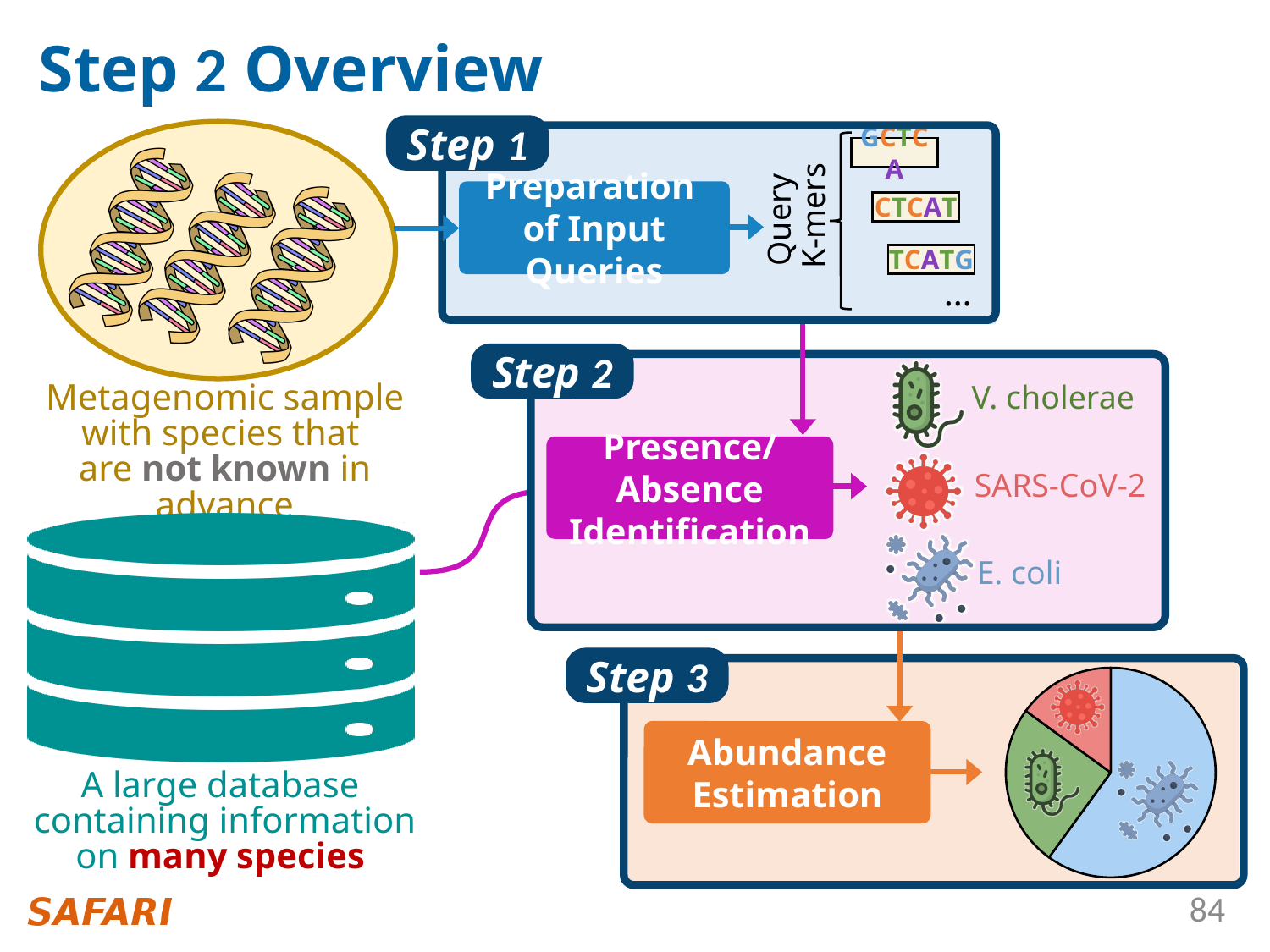
What kind of chart is shown in the Step 3 box? pie chart In the pie chart in the Step 3 box, is the blue slice larger or smaller than the green slice? larger Does the pie chart in the Step 3 box show any data labels or percentages? No How many slices does the pie chart in the Step 3 box have? 3 Which colour slice is the smallest in the pie chart in the Step 3 box? red Which colour slice is the largest in the pie chart in the Step 3 box? blue